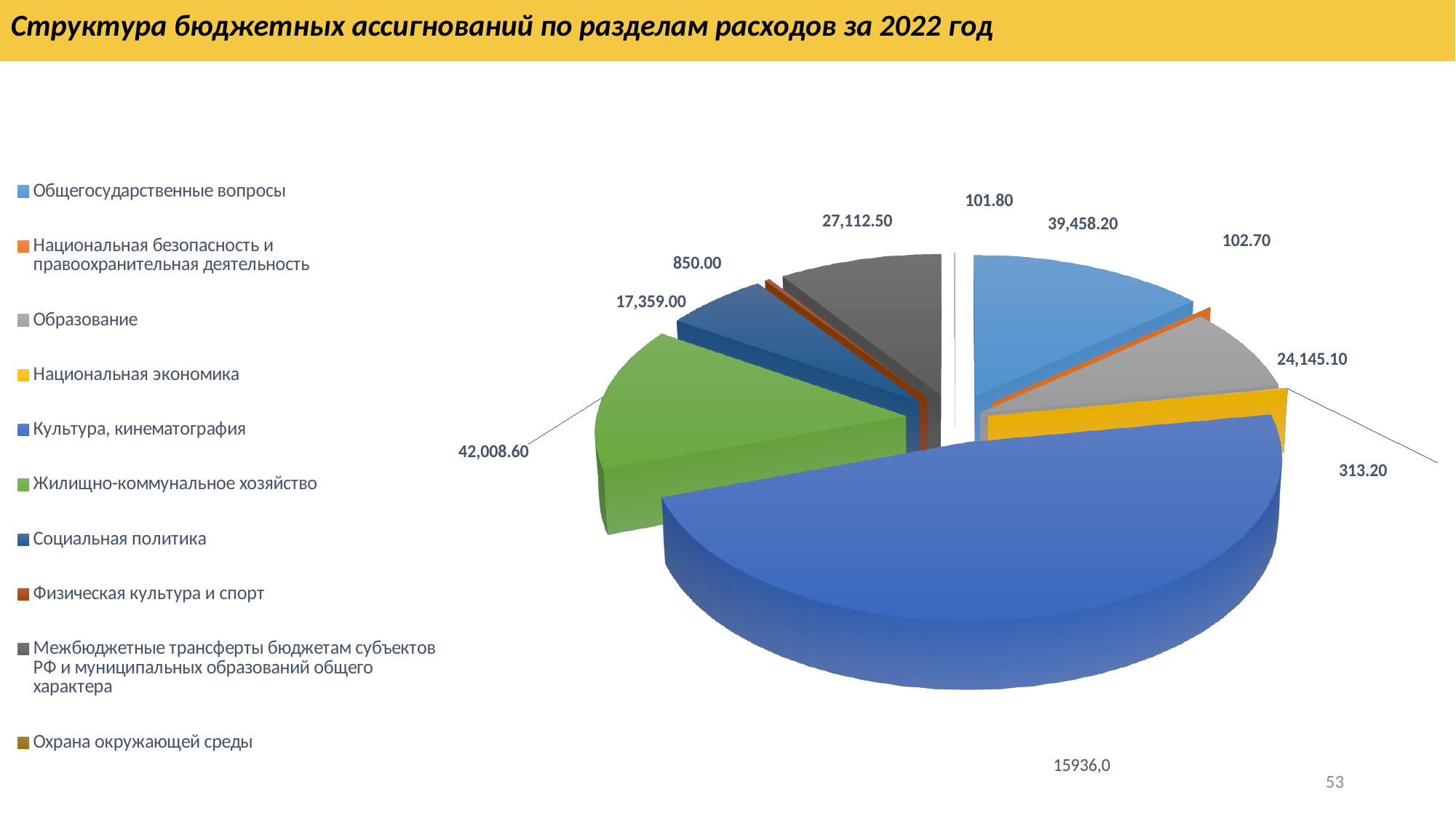
What is the title of the chart on the slide? Структура бюджетных ассигнований по разделам расходов за 2022 год What is the value shown for Социальная политика? 17,359.00 How many categories does the legend of the pie chart list? 10 What is the value shown for Образование? 24,145.10 What kind of chart is shown on the slide? pie chart What is the value shown for Общегосударственные вопросы? 39,458.20 Which is larger: Общегосударственные вопросы or Образование? Общегосударственные вопросы What is the value shown for Физическая культура и спорт? 850.00 Which category has the largest slice of the pie? Культура, кинематография What is the value shown for Жилищно-коммунальное хозяйство? 42,008.60 What is the value shown for Межбюджетные трансферты бюджетам субъектов РФ и муниципальных образований общего характера? 27,112.50 What is the difference between the values for Жилищно-коммунальное хозяйство and Межбюджетные трансферты бюджетам субъектов РФ и муниципальных образований общего характера? 14,896.10